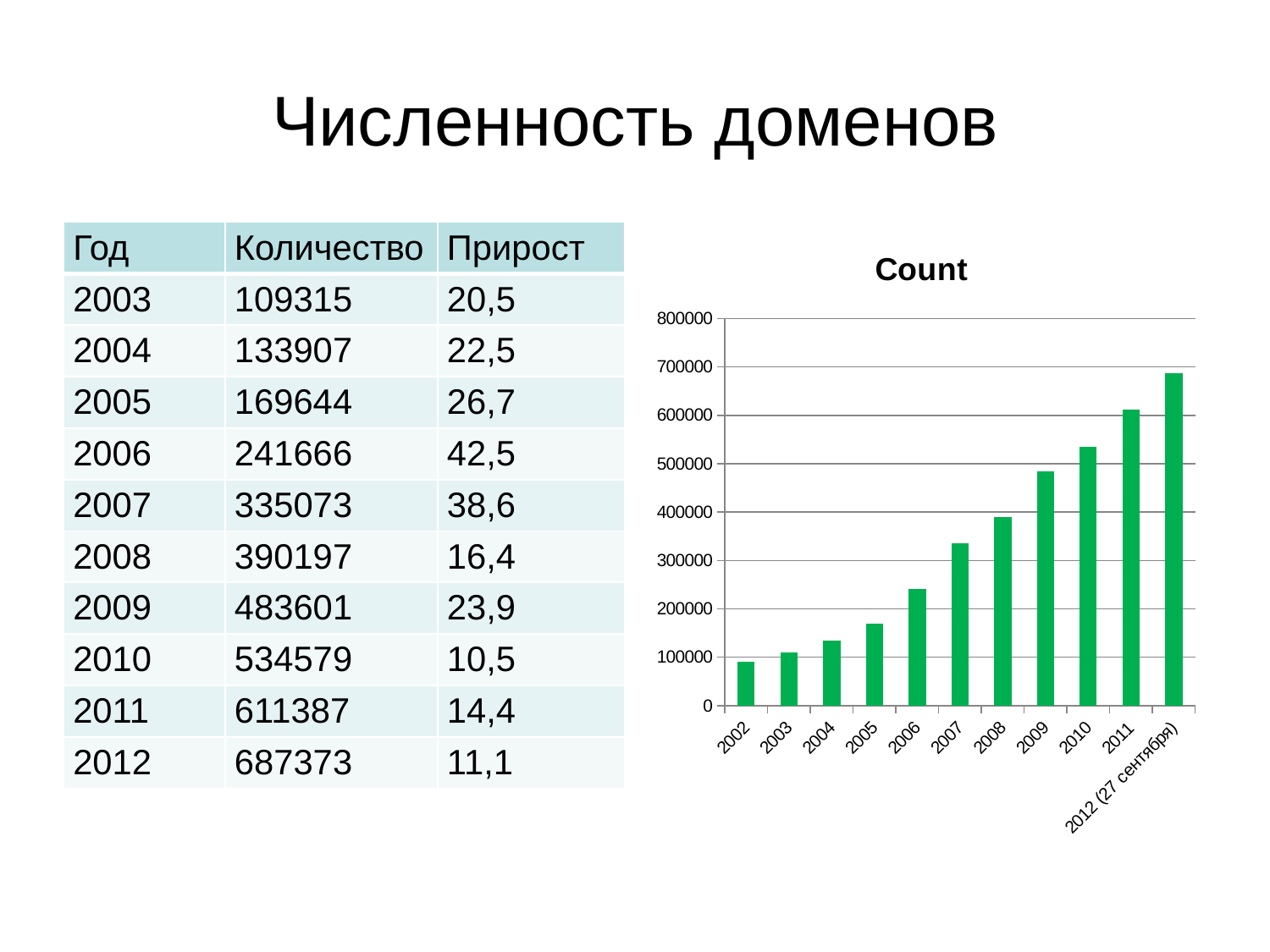
Which year has the highest bar in the chart? 2012 (27 сентября) According to the slide, what is the count for 2006? 241666 What is the title of the chart? Count Is the value for 2009 greater or less than 400000? greater Do the values in the chart rise or fall from 2002 to 2012? rise Which is larger, the value for 2007 or the value for 2010? 2010 Which year has the lowest bar in the chart? 2002 Is the value for 2002 greater or less than 100000? less According to the slide, what is the count for 2010? 534579 Is the value for 2011 greater or less than 700000? less How many bars does the chart have? 11 What kind of chart is shown on the slide? bar chart